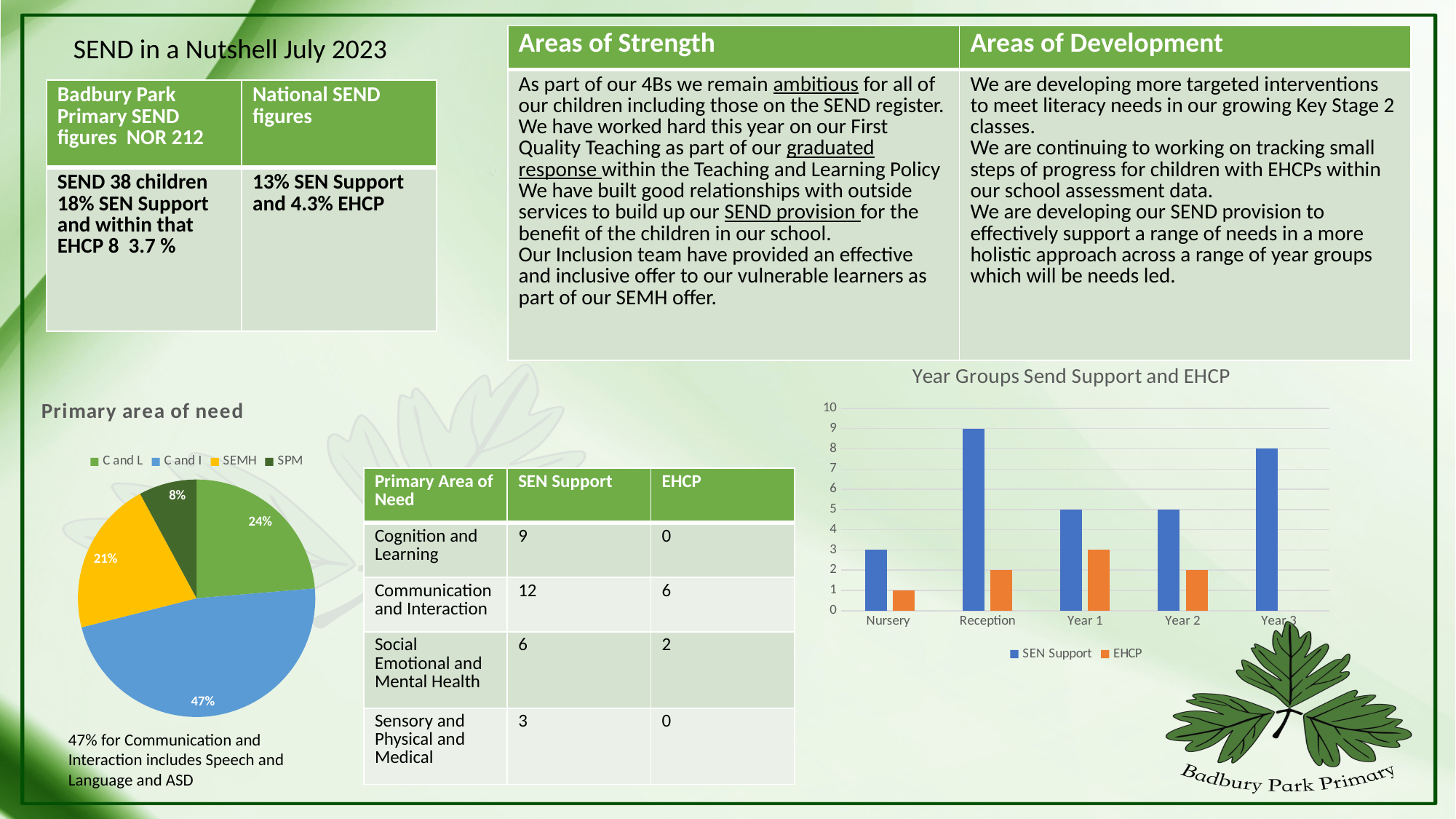
In the 'Primary area of need' pie chart, what share does C and I have? 47% In the 'Year Groups Send Support and EHCP' chart, what is the EHCP value for Year 1? 3 What kind of chart is 'Year Groups Send Support and EHCP'? Bar chart In the 'Primary area of need' pie chart, which category has the largest slice? C and I In the 'Year Groups Send Support and EHCP' chart, is the SEN Support value for Year 3 greater or less than 5? greater In the 'Year Groups Send Support and EHCP' chart, which is larger: SEN Support for Nursery or SEN Support for Year 1? Year 1 In the 'Primary area of need' pie chart, which category has the smallest slice? SPM In the 'Year Groups Send Support and EHCP' chart, which year group has the highest SEN Support value? Reception How many categories does the 'Primary area of need' pie chart legend list? 4 In the 'Year Groups Send Support and EHCP' chart, what is the SEN Support value for Reception? 9 In the 'Year Groups Send Support and EHCP' chart, how many series does the legend list? 2 In the 'Primary area of need' pie chart, what share does SEMH have? 21%